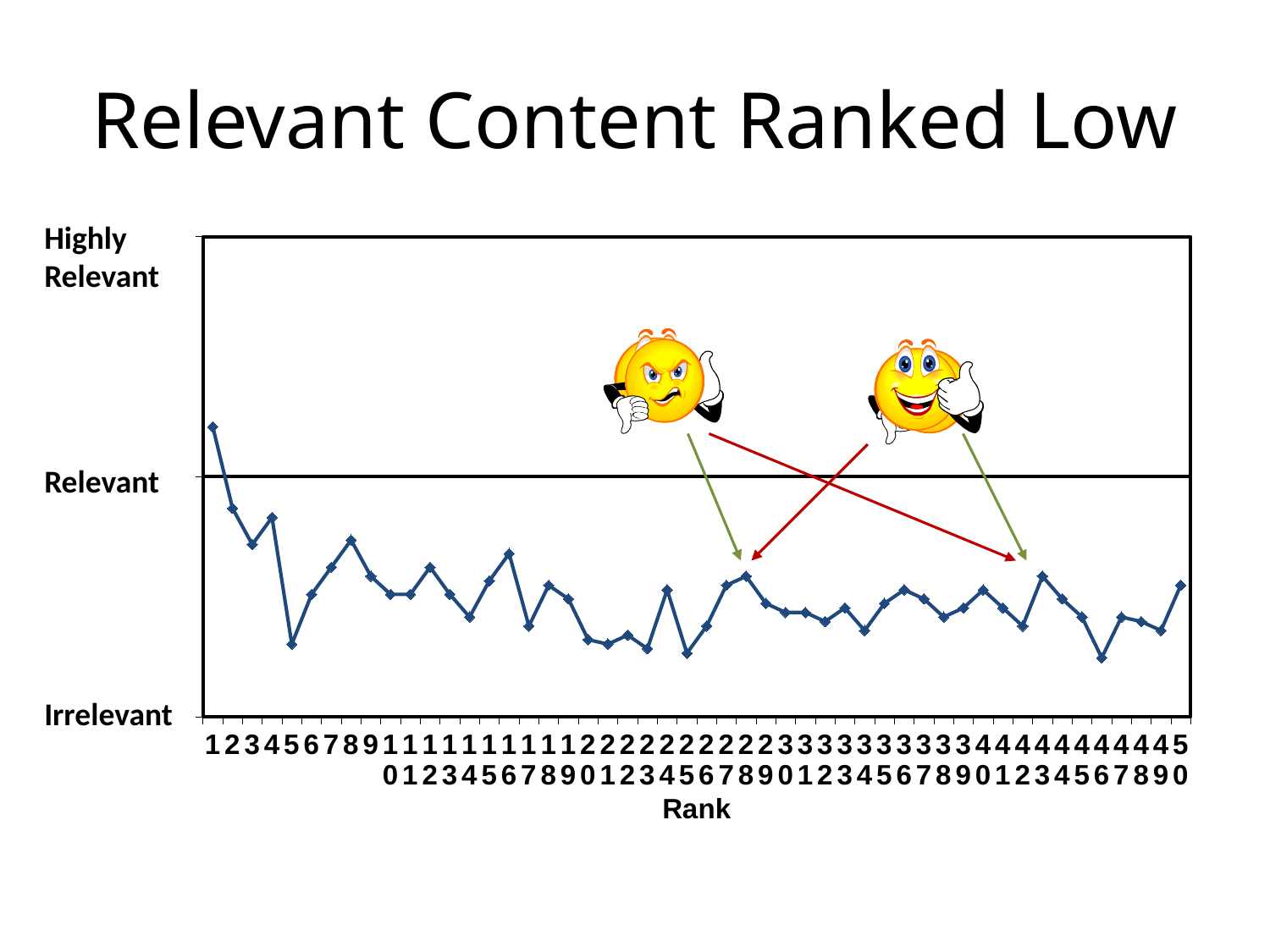
What is the title of the chart on the slide? Relevant Content Ranked Low Does the relevance value generally rise or fall as rank increases from 1 to 5? fall How many plotted points lie above the 'Relevant' line? 1 At which rank is the plotted relevance value highest? 1 Is the value at rank 1 above or below the 'Relevant' line? above What is the label of the x axis? Rank What kind of chart is shown on the slide? line chart What is the label at the top of the y axis? Highly Relevant Which has the higher relevance value, rank 2 or rank 45? rank 2 Is the value at rank 25 above or below the 'Relevant' line? below Which has the higher relevance value, rank 1 or rank 5? rank 1 How many ranks (data points) are plotted along the x axis? 50